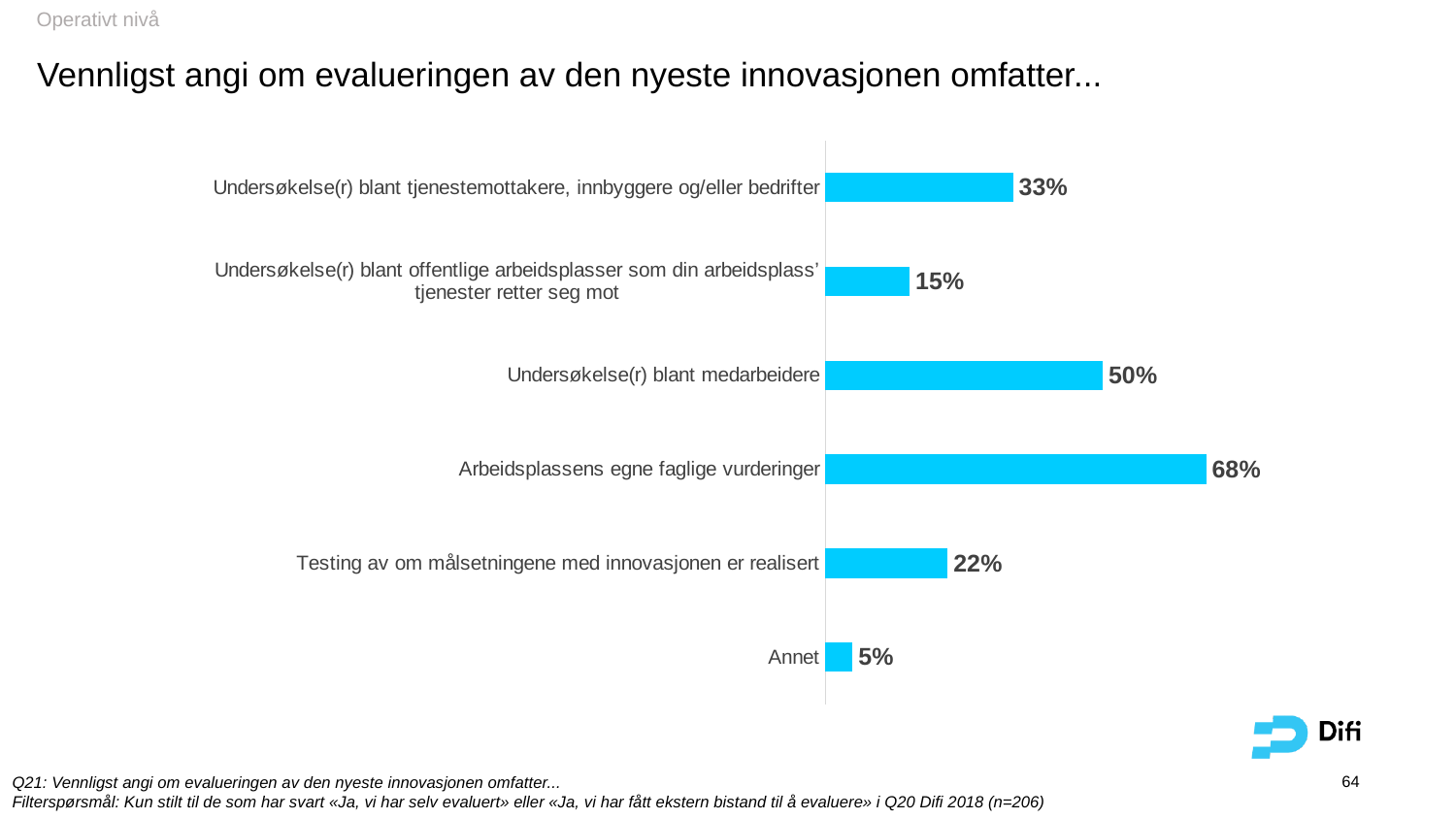
What is the difference between the values for "Undersøkelse(r) blant tjenestemottakere, innbyggere og/eller bedrifter" and "Undersøkelse(r) blant offentlige arbeidsplasser som din arbeidsplass' tjenester retter seg mot"? 18% What is the difference between the values for "Arbeidsplassens egne faglige vurderinger" and "Undersøkelse(r) blant medarbeidere"? 18% What kind of chart is shown on the slide? Bar chart How many categories are shown in the chart? 6 What colour are the bars in the chart? Light blue Which is larger: the value for "Undersøkelse(r) blant tjenestemottakere, innbyggere og/eller bedrifter" or the value for "Testing av om målsetningene med innovasjonen er realisert"? Undersøkelse(r) blant tjenestemottakere, innbyggere og/eller bedrifter What is the value for "Testing av om målsetningene med innovasjonen er realisert"? 22% Which category has the lowest value? Annet Which category has the highest value? Arbeidsplassens egne faglige vurderinger What is the value for "Arbeidsplassens egne faglige vurderinger"? 68% What is the value for "Annet"? 5% What is the value for "Undersøkelse(r) blant medarbeidere"? 50%